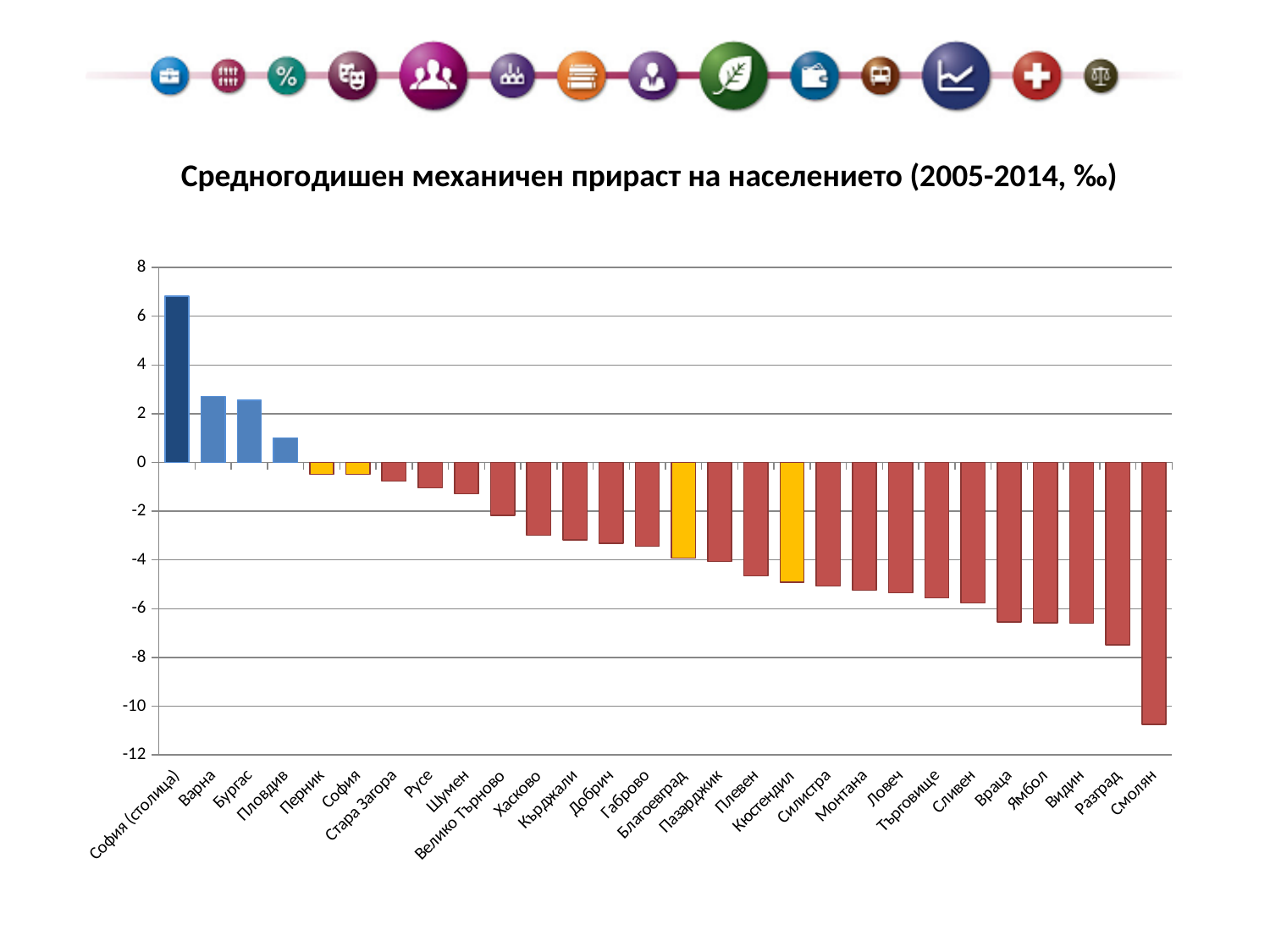
Do the values rise or fall moving from left to right along the x axis? fall Is the value for София (столица) greater or less than 6? greater Which category has the lowest value? Смолян What kind of chart is shown on the slide? bar chart Which is larger, the value for Варна or the value for Пловдив? Варна How many categories are plotted on the chart? 28 Which is larger, the value for Разград or the value for Смолян? Разград What is the title of the chart? Средногодишен механичен прираст на населението (2005-2014, ‰) Is the value for Смолян greater or less than -10? less Is the value for Разград greater or less than -6? less Which category has the highest value? София (столица)